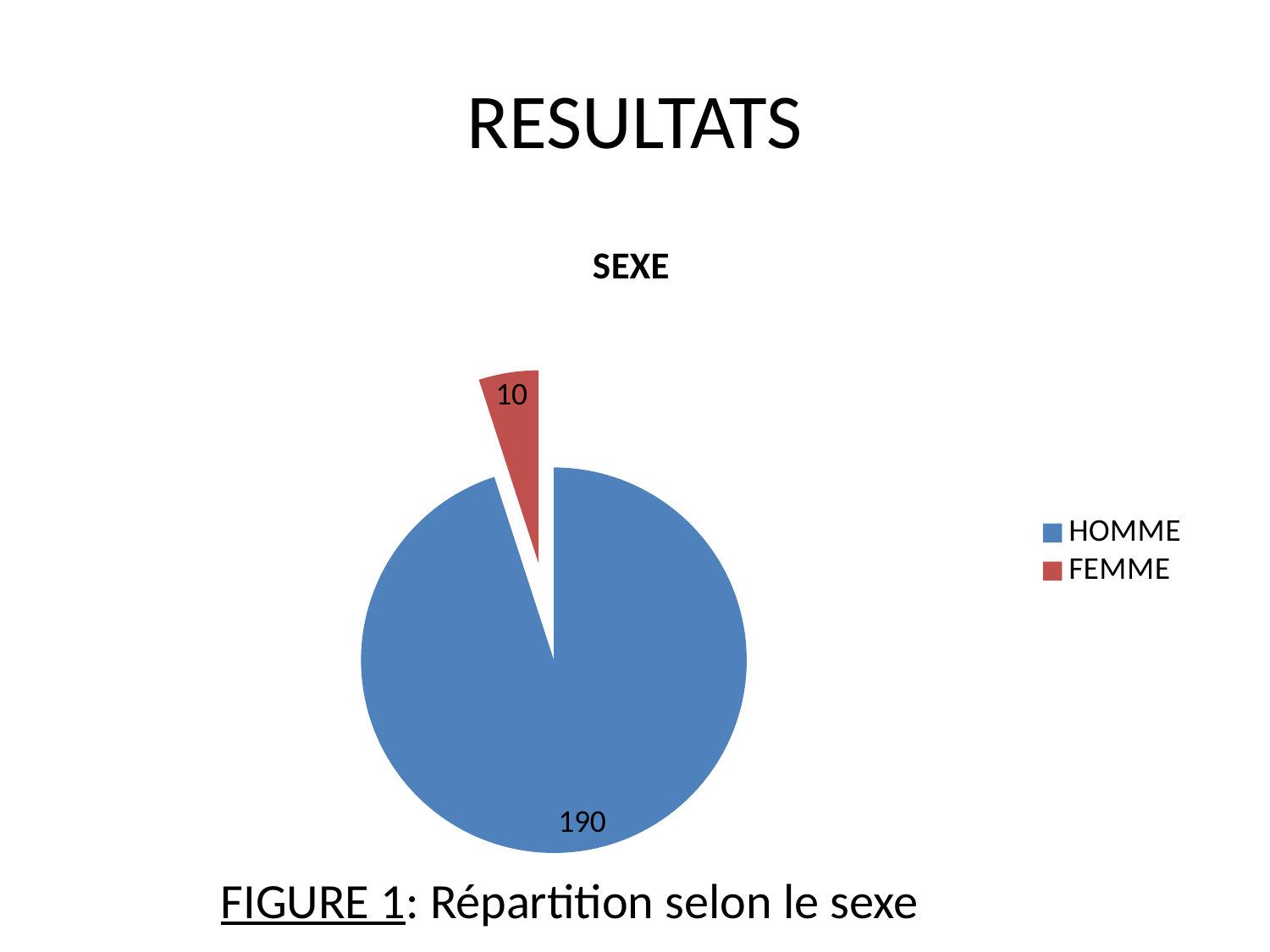
Which is larger in the SEXE pie chart, HOMME or FEMME? HOMME What share of the SEXE pie chart does FEMME represent? 5% What is the total of all slices in the SEXE pie chart? 200 Which category has the largest slice in the SEXE pie chart? HOMME What is the value for FEMME in the SEXE pie chart? 10 Which category has the smallest slice in the SEXE pie chart? FEMME What kind of chart is shown on the slide? Pie chart How many categories are shown in the SEXE pie chart? 2 What is the difference between the HOMME and FEMME values in the SEXE pie chart? 180 What share of the SEXE pie chart does HOMME represent? 95% What is the title of the pie chart on the slide? SEXE What is the value for HOMME in the SEXE pie chart? 190